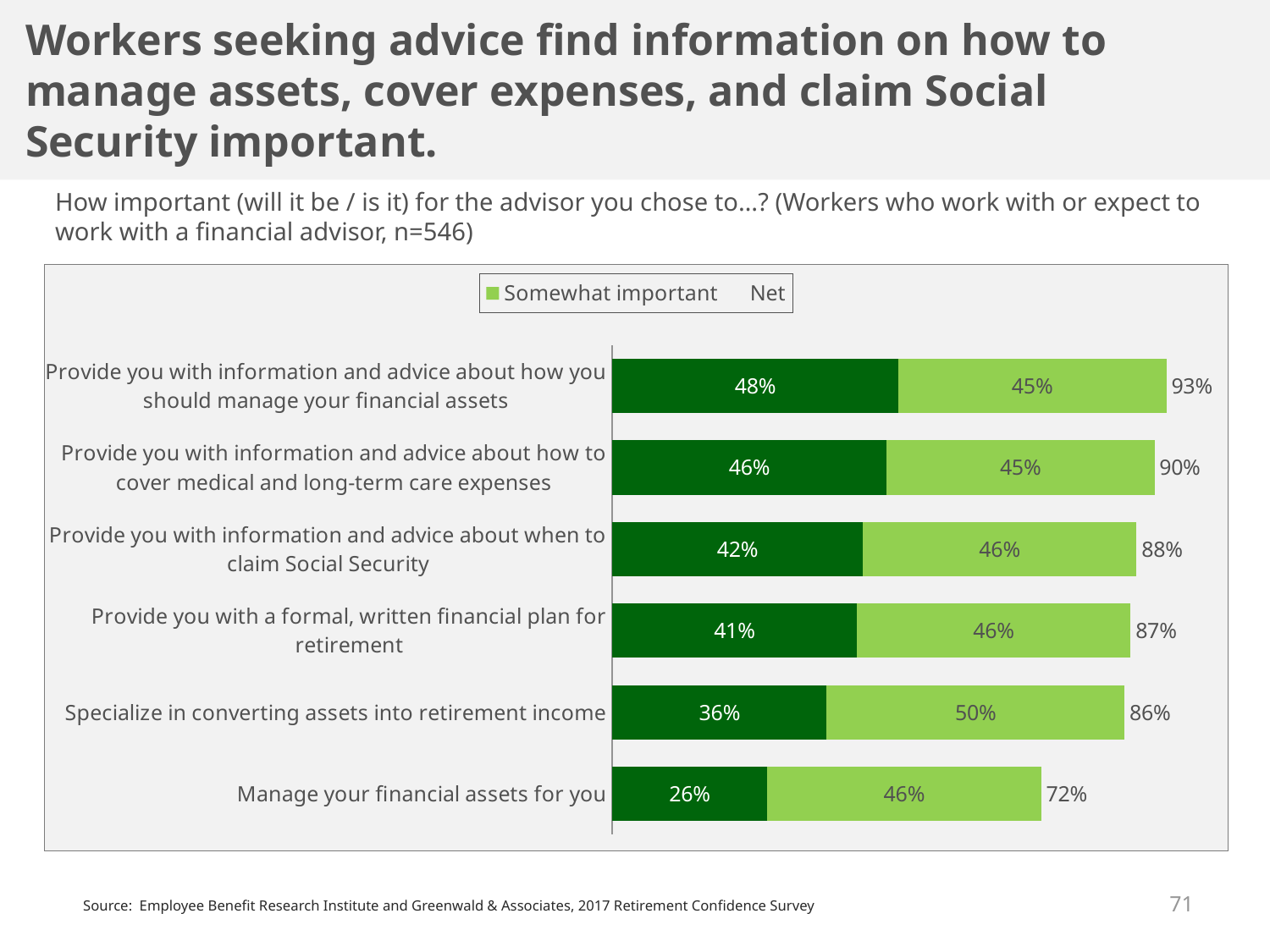
What is the value of the dark green segment for "Provide you with information and advice about when to claim Social Security"? 42% What is the total (Net) of the stacked bar for "Provide you with information and advice about how to cover medical and long-term care expenses"? 90% How many items (bars) are shown in the chart? 6 What is the difference between the Net value for "Provide you with information and advice about how you should manage your financial assets" and the Net value for "Manage your financial assets for you"? 21 percentage points Which item has the lowest Net value? Manage your financial assets for you What are the two entries shown in the chart legend? Somewhat important and Net Which item has the highest Net value? Provide you with information and advice about how you should manage your financial assets Which has a larger "Somewhat important" value: "Specialize in converting assets into retirement income" or "Provide you with a formal, written financial plan for retirement"? Specialize in converting assets into retirement income What type of chart is shown on the slide? Stacked bar chart How many entries does the chart legend list? 2 What percentage said "Somewhat important" for "Specialize in converting assets into retirement income"? 50% What is the Net value for "Manage your financial assets for you"? 72%